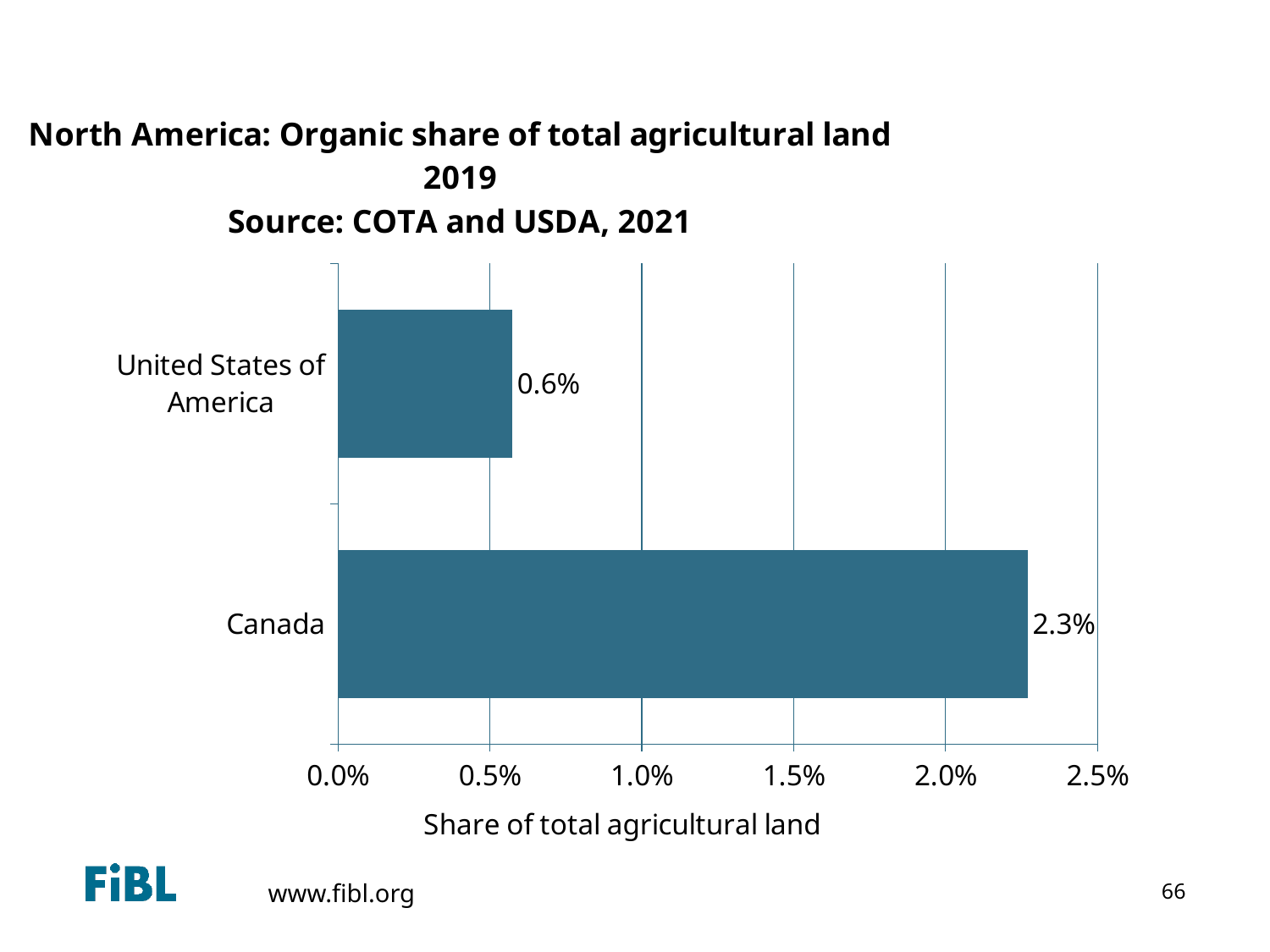
Which has a larger organic share of agricultural land, Canada or the United States of America? Canada What is the organic share of total agricultural land for the United States of America? 0.6% What is the difference in organic share between Canada and the United States of America? 1.7% What source is cited in the chart title? COTA and USDA, 2021 Which country has the lowest organic share of total agricultural land? United States of America What is the label of the horizontal axis? Share of total agricultural land Is the value for Canada greater or less than 2.0%? greater How many countries are shown in the chart? 2 Is the value for the United States of America greater or less than 1.0%? less What type of chart is shown on the slide? Bar chart What is the organic share of total agricultural land for Canada? 2.3% Which country has the highest organic share of total agricultural land? Canada